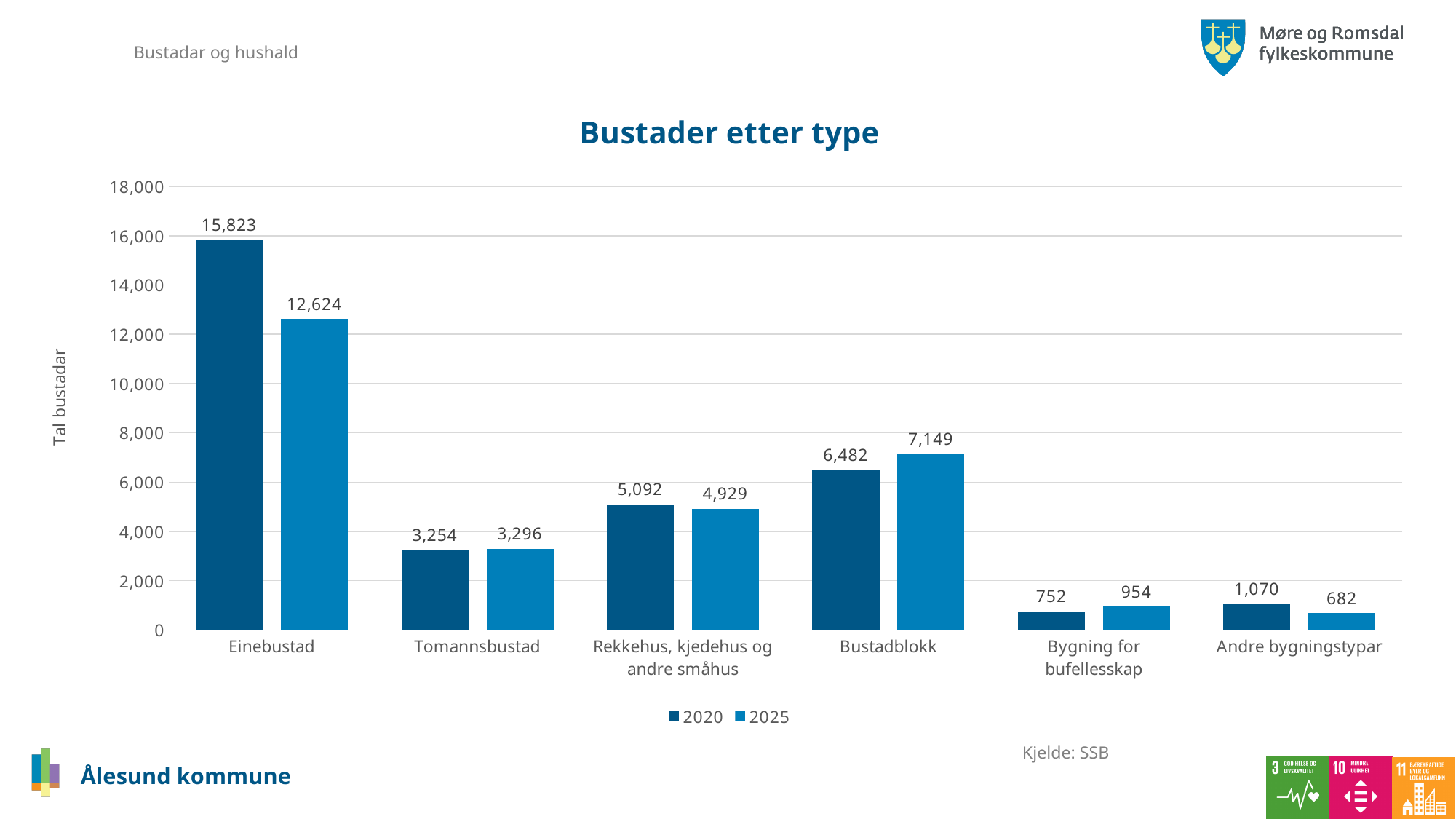
What is the value for Bygning for bufellesskap in 2020? 752 What is the title of the chart? Bustader etter type Is the 2020 value for Rekkehus, kjedehus og andre småhus greater or less than 4,000? greater What kind of chart is shown on the slide? bar chart Which category has the lowest value in 2025? Andre bygningstypar How many series does the legend list? 2 What is the value for Einebustad in 2020? 15,823 What is the value for Bustadblokk in 2025? 7,149 Which is larger for Bustadblokk, the 2020 value or the 2025 value? 2025 How many categories are shown on the x axis? 6 What is the difference between the 2020 and 2025 values for Einebustad? 3,199 Which category has the highest value in 2025? Einebustad